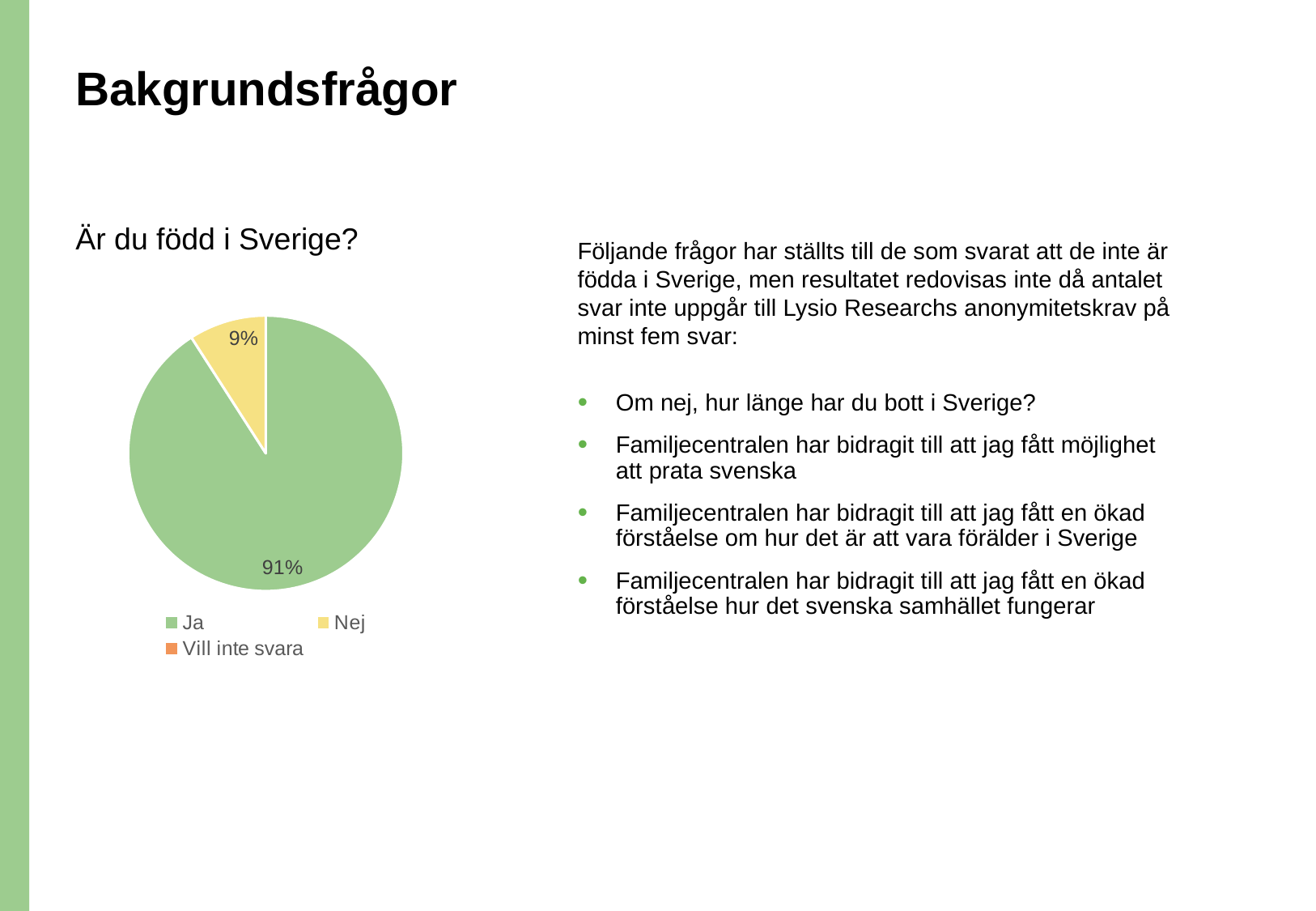
Is the share for Ja greater or less than 50%? greater What kind of chart is shown on the slide? Pie chart Is the share for Nej greater or less than 25%? less Which slice of the pie chart is the largest? Ja Which of the two labelled slices, Ja or Nej, is larger? Ja What question does the pie chart answer, according to the heading above it? Är du född i Sverige? How many entries does the chart's legend list? 3 What share of the pie chart is labelled "Ja"? 91% What share of the pie chart is labelled "Nej"? 9% What colour is the "Ja" slice in the pie chart? Green What is the difference in percentage points between the Ja and Nej slices? 82